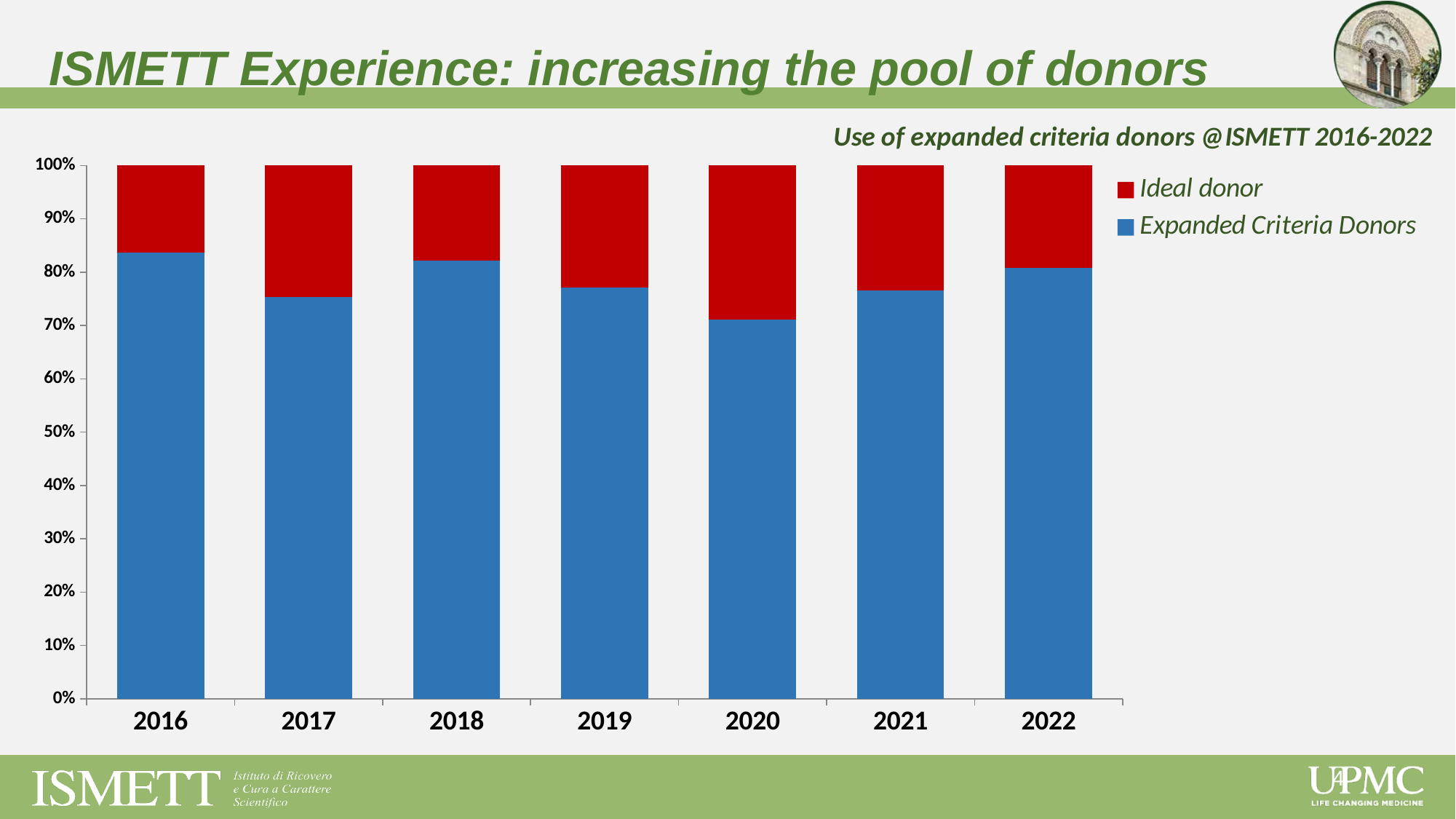
What is the title of the chart? Use of expanded criteria donors @ISMETT 2016-2022 Which series is shown in red in the chart? Ideal donor Which year has a larger share of Expanded Criteria Donors, 2018 or 2021? 2018 Which year has the largest share of Ideal donor? 2020 Is the share of Expanded Criteria Donors in 2017 greater or less than 80%? less Which year has a larger share of Expanded Criteria Donors, 2016 or 2020? 2016 What kind of chart is shown on the slide? Stacked bar chart Is the share of Expanded Criteria Donors in 2016 greater or less than 80%? greater Is the share of Expanded Criteria Donors in 2020 greater or less than 80%? less How many series does the chart legend list? 2 Which year has the lowest share of Expanded Criteria Donors? 2020 How many years are shown on the x axis of the chart? 7